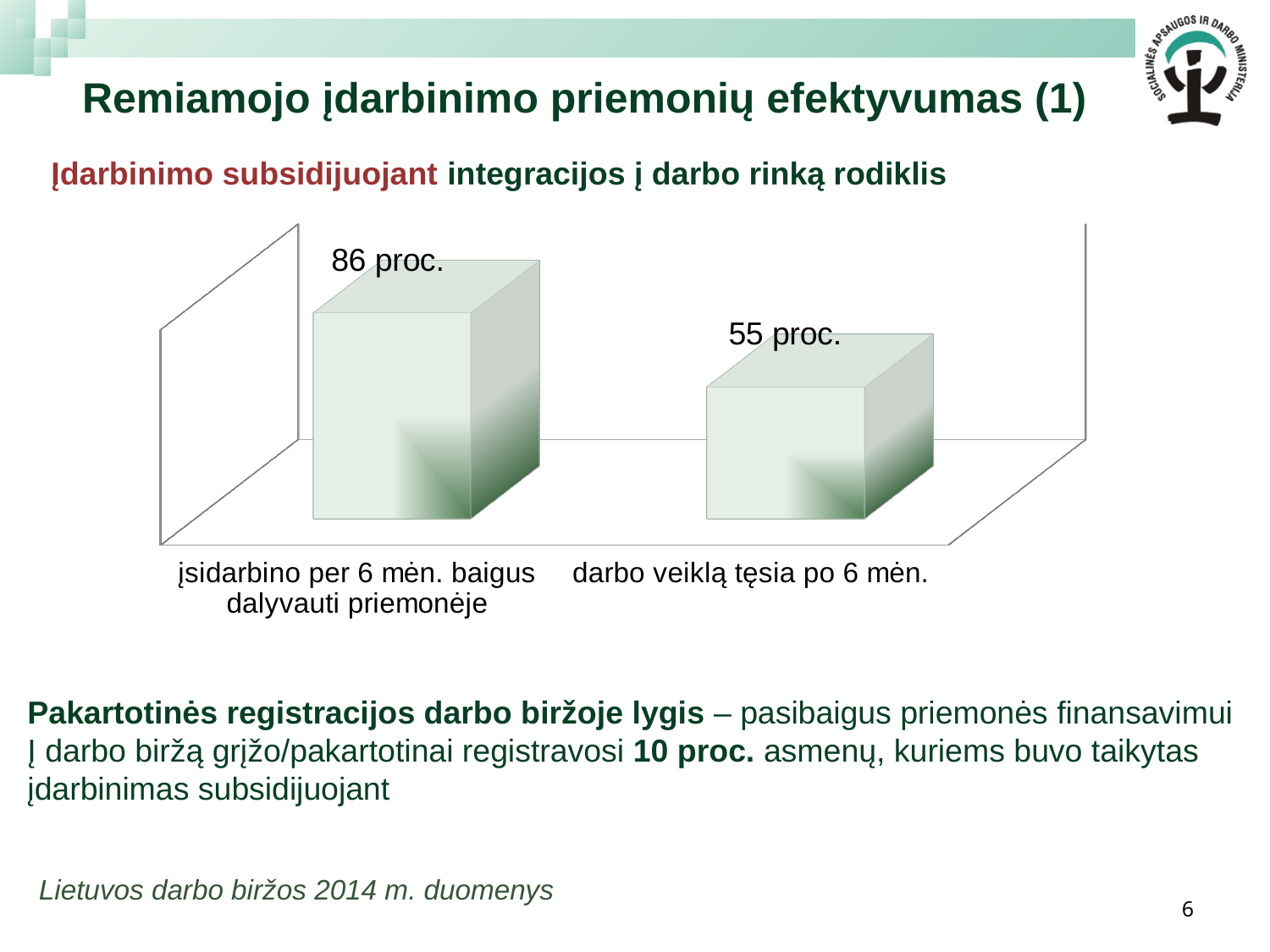
What is the label of the right bar in the chart? darbo veiklą tęsia po 6 mėn. What kind of chart is shown on the slide? bar chart What is the difference between the value for "įsidarbino per 6 mėn. baigus dalyvauti priemonėje" and the value for "darbo veiklą tęsia po 6 mėn."? 31 proc. Which category has the lowest value? darbo veiklą tęsia po 6 mėn. Do the values rise or fall from the left category to the right category? fall What is the value for "įsidarbino per 6 mėn. baigus dalyvauti priemonėje"? 86 proc. What is the label of the left bar in the chart? įsidarbino per 6 mėn. baigus dalyvauti priemonėje What is the value for "darbo veiklą tęsia po 6 mėn."? 55 proc. Which is larger: the value for "įsidarbino per 6 mėn. baigus dalyvauti priemonėje" or the value for "darbo veiklą tęsia po 6 mėn."? įsidarbino per 6 mėn. baigus dalyvauti priemonėje Which category has the highest value? įsidarbino per 6 mėn. baigus dalyvauti priemonėje How many categories are shown in the chart? 2